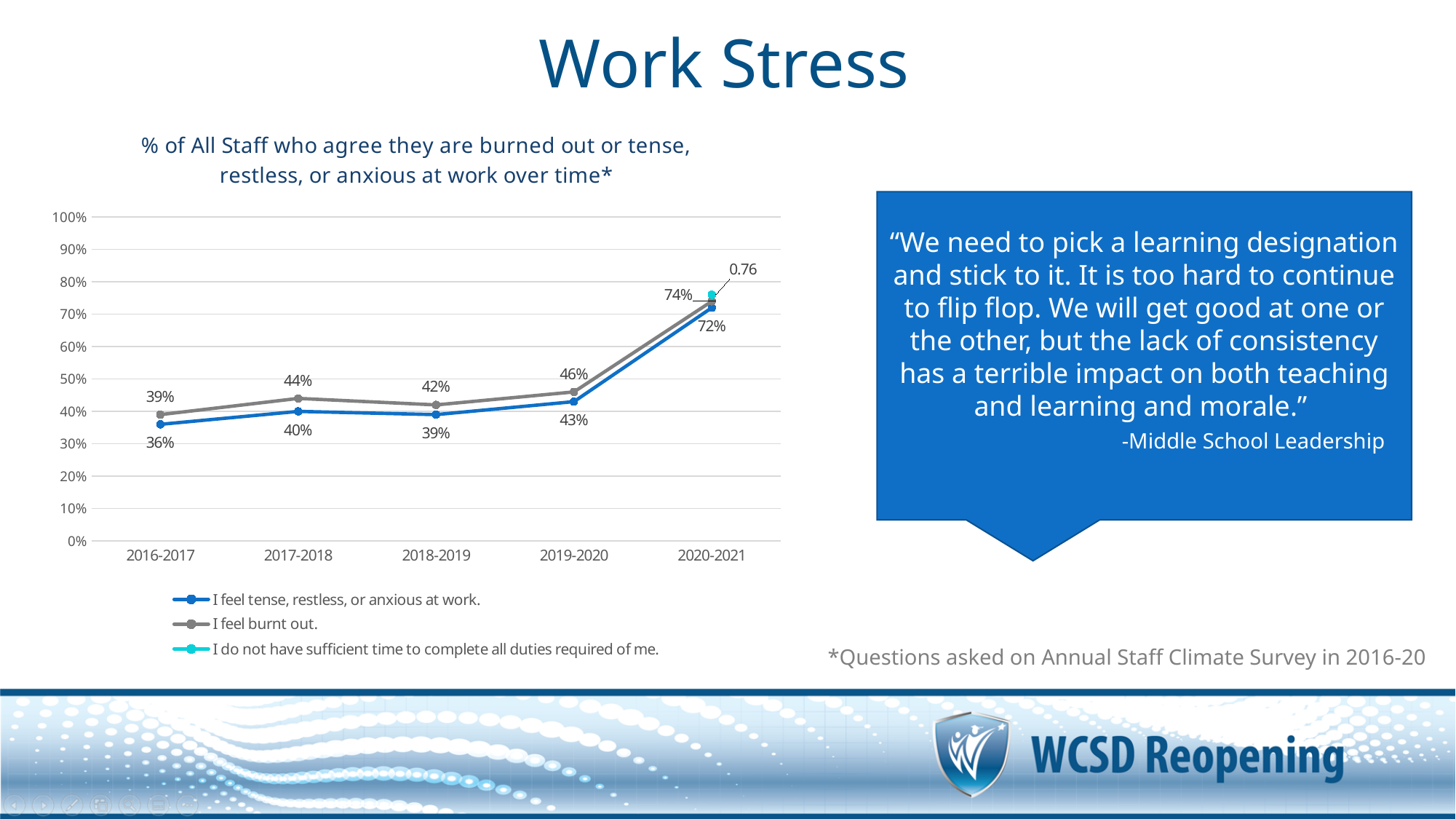
How many series does the legend list? 3 What is the difference between "I feel burnt out." and "I feel tense, restless, or anxious at work." in 2019-2020? 3% What kind of chart is shown on the slide? line chart What is the value for "I feel tense, restless, or anxious at work." in 2020-2021? 72% What percentage of staff agreed with "I feel burnt out." in 2017-2018? 44% In which school year is the "I feel tense, restless, or anxious at work." series lowest? 2016-2017 Is the value for "I feel tense, restless, or anxious at work." in 2019-2020 greater or less than 50%? less What value is labelled for "I do not have sufficient time to complete all duties required of me." in 2020-2021? 0.76 How many school years are shown on the x axis? 5 In which school year is the "I feel burnt out." series highest? 2020-2021 In 2018-2019, which series has the higher value: "I feel burnt out." or "I feel tense, restless, or anxious at work."? I feel burnt out. Does the "I feel burnt out." series rise or fall from 2019-2020 to 2020-2021? rise